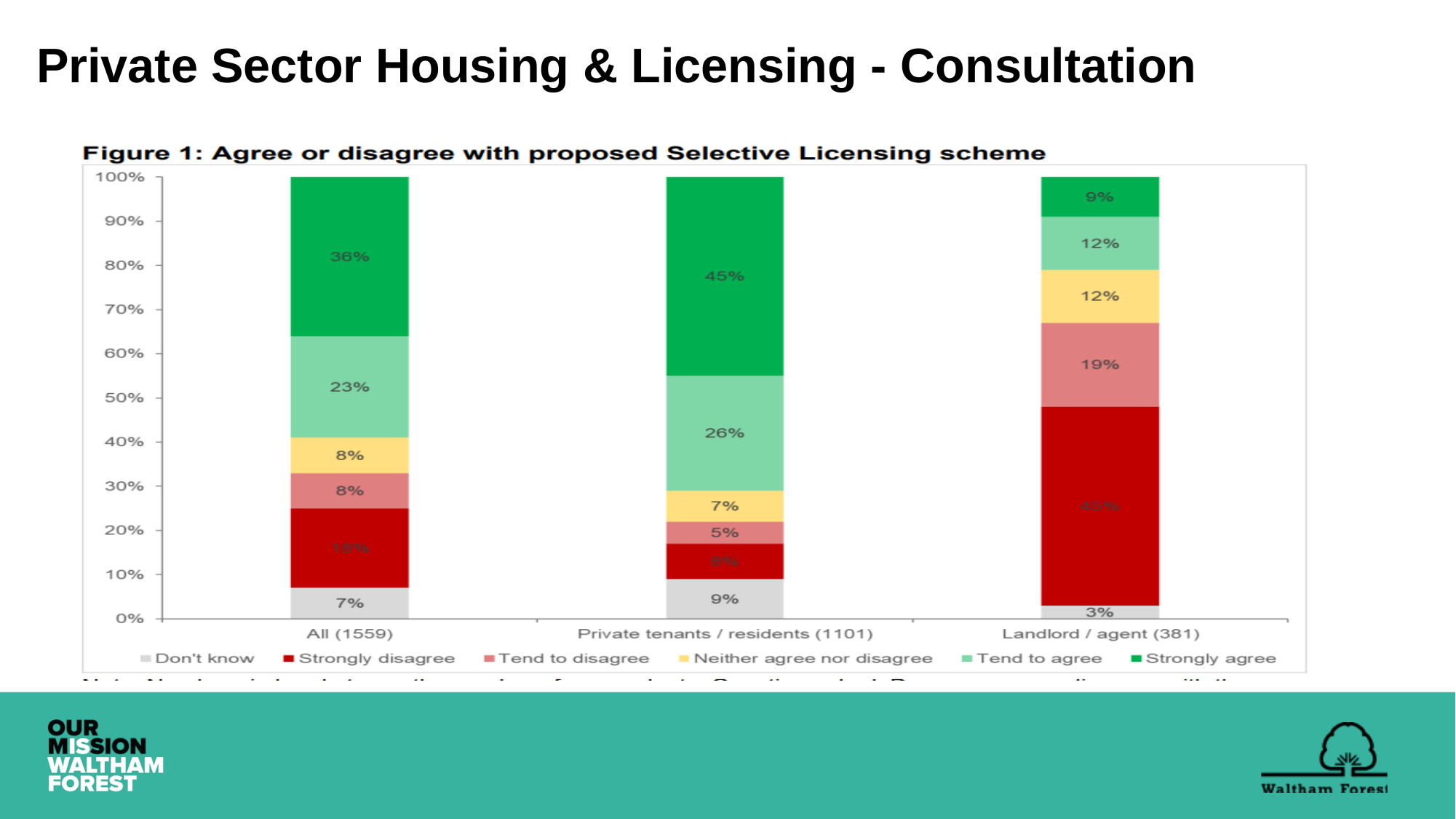
Which respondent group has the highest share of Strongly agree responses? Private tenants / residents (1101) What kind of chart is shown in Figure 1? Stacked bar chart What percentage of Landlord / agent (381) respondents answered Don't know? 3% How many respondent groups are shown on the x axis of Figure 1? 3 Which respondent group has the lowest share of Don't know responses? Landlord / agent (381) What percentage of Landlord / agent (381) respondents tend to disagree? 19% What percentage of the All (1559) group strongly agree with the proposed Selective Licensing scheme? 36% How many response categories does the legend of Figure 1 list? 6 Which is larger for the All (1559) group: the Tend to agree share or the Neither agree nor disagree share? Tend to agree What is the difference between the Tend to agree share for Private tenants / residents (1101) and for Landlord / agent (381)? 14 percentage points Is the Strongly disagree share for Landlord / agent (381) greater or less than 40%? greater What percentage of Private tenants / residents (1101) strongly agree? 45%